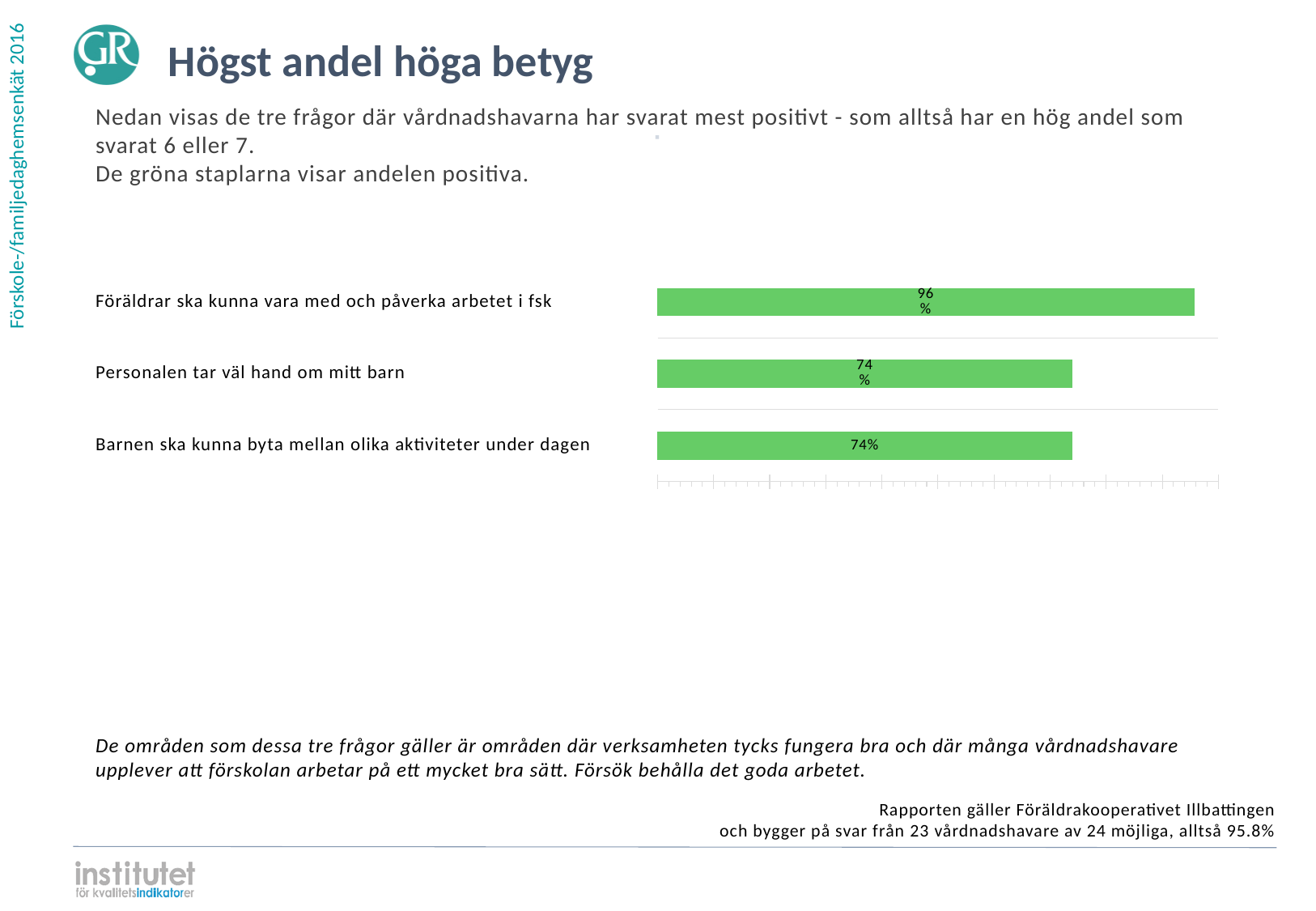
What is the value for "Barnen ska kunna byta mellan olika aktiviteter under dagen"? 74% What kind of chart is shown on the slide? Bar chart Which category has the highest value? Föräldrar ska kunna vara med och påverka arbetet i fsk What colour are the bars in the chart? Green What is the difference between the values for "Föräldrar ska kunna vara med och påverka arbetet i fsk" and "Personalen tar väl hand om mitt barn"? 22 percentage points Do "Personalen tar väl hand om mitt barn" and "Barnen ska kunna byta mellan olika aktiviteter under dagen" have the same value? Yes What is the value for "Personalen tar väl hand om mitt barn"? 74% Which is larger: the value for "Föräldrar ska kunna vara med och påverka arbetet i fsk" or the value for "Barnen ska kunna byta mellan olika aktiviteter under dagen"? Föräldrar ska kunna vara med och påverka arbetet i fsk What is the value for "Föräldrar ska kunna vara med och påverka arbetet i fsk"? 96% How many categories are shown in the chart? 3 What is the title of the slide containing the chart? Högst andel höga betyg